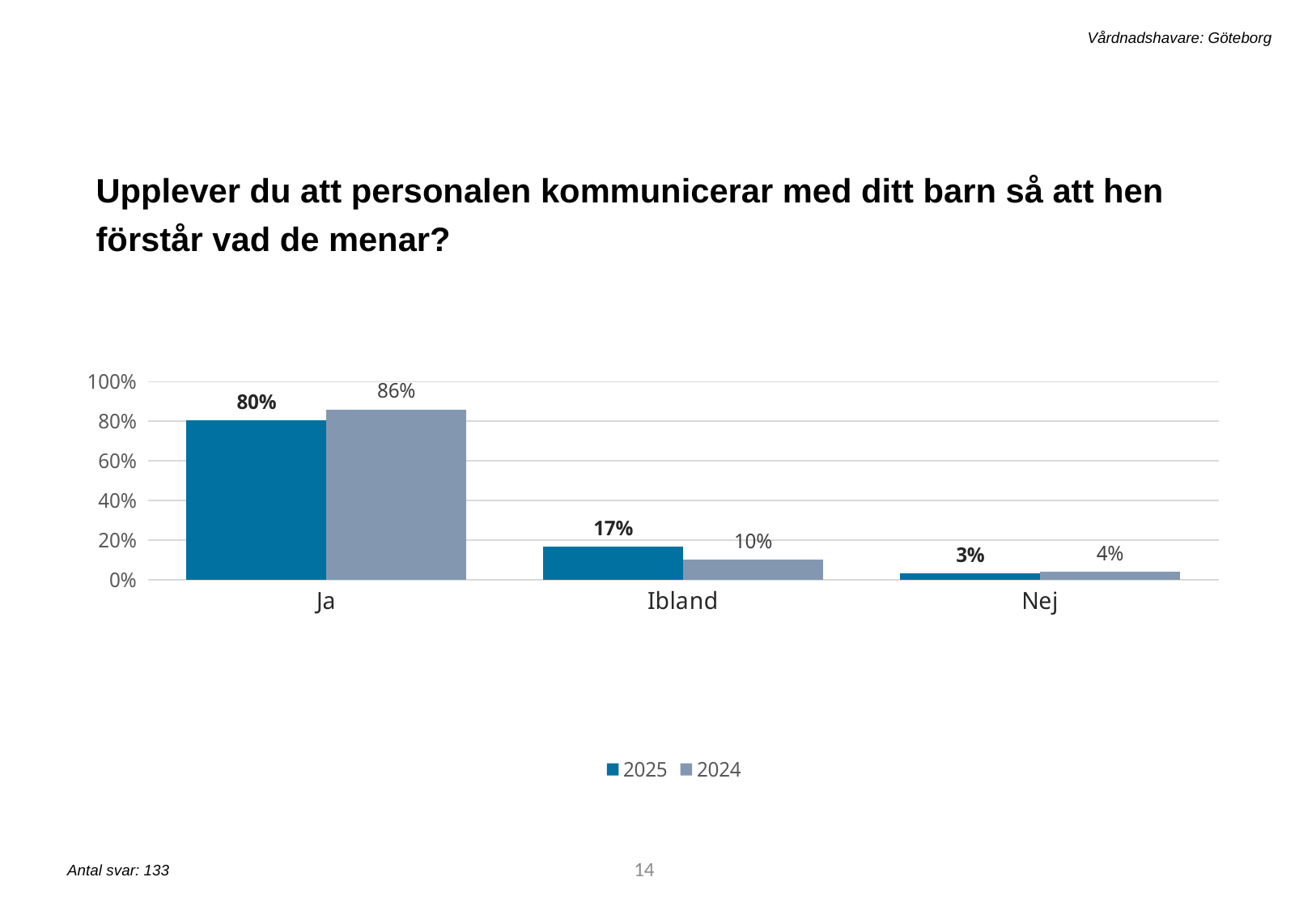
Which series is shown in the darker blue colour? 2025 Is the 2024 value for "Ja" greater or less than 80%? greater What is the value for "Ibland" in the 2024 series? 10% What is the value for "Nej" in the 2025 series? 3% How many categories are shown on the x axis? 3 What is the difference between the 2024 and 2025 values for "Ja"? 6% What is the value for "Ja" in the 2025 series? 80% Which category has the lowest value in the 2025 series? Nej How many series does the legend list? 2 Which category has the highest value in the 2024 series? Ja What kind of chart is shown on the slide? bar chart Which is larger for "Ibland": the 2025 value or the 2024 value? 2025